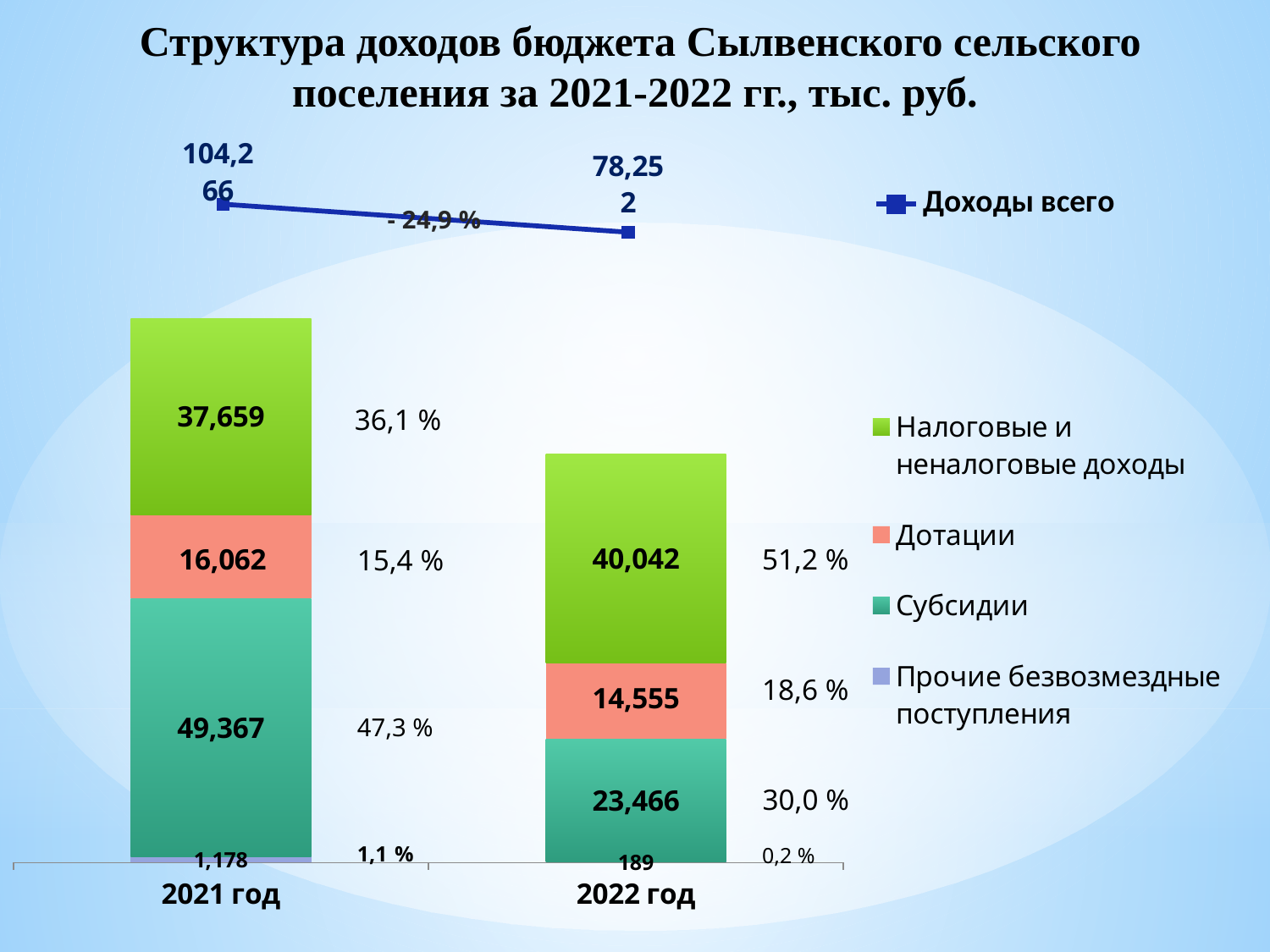
Which series has the largest value in the 2021 год bar? Субсидии What is the difference between the Субсидии values for 2021 год and 2022 год? 25,901 What is the Доходы всего value for 2021 год? 104,266 What is the Доходы всего value for 2022 год? 78,252 What is the value of Дотации for 2021 год? 16,062 Which is larger: Налоговые и неналоговые доходы in 2021 год or in 2022 год? 2022 год What percentage share is shown for Дотации in 2022 год? 18,6 % Which series has the smallest value in the 2022 год bar? Прочие безвозмездные поступления What kind of chart is shown on the slide? Stacked bar chart with a line What is the value of Налоговые и неналоговые доходы for 2021 год? 37,659 What is the value of Прочие безвозмездные поступления for 2022 год? 189 What is the value of Субсидии for 2022 год? 23,466